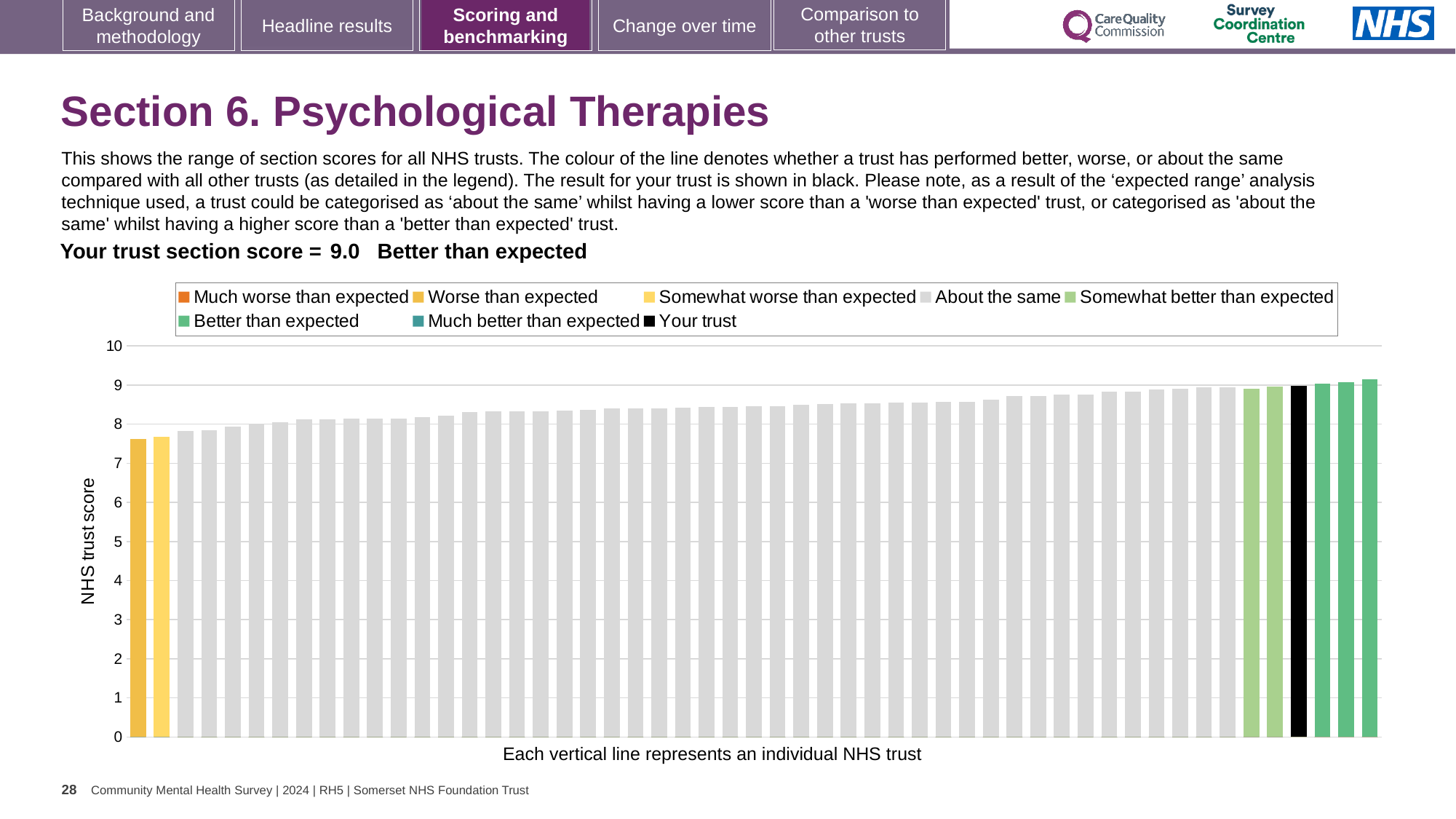
Is the value of the lowest bar in the chart greater or less than 8? less Do the bar values rise or fall from left to right along the x axis? rise Is the value of the highest bar in the chart greater or less than 10? less Is the value of the black 'Your trust' bar greater or less than 8? greater What is the section score for your trust shown on the slide? 9.0 How many bars are coloured as 'Worse than expected' (yellow) in the chart? 1 What is the label on the vertical axis of the chart? NHS trust score What kind of chart is shown on the slide? bar chart What colour is the bar representing your trust in the chart? black How many bars are coloured as 'Better than expected' (green) in the chart, excluding the black 'Your trust' bar? 3 How many entries does the chart legend list? 8